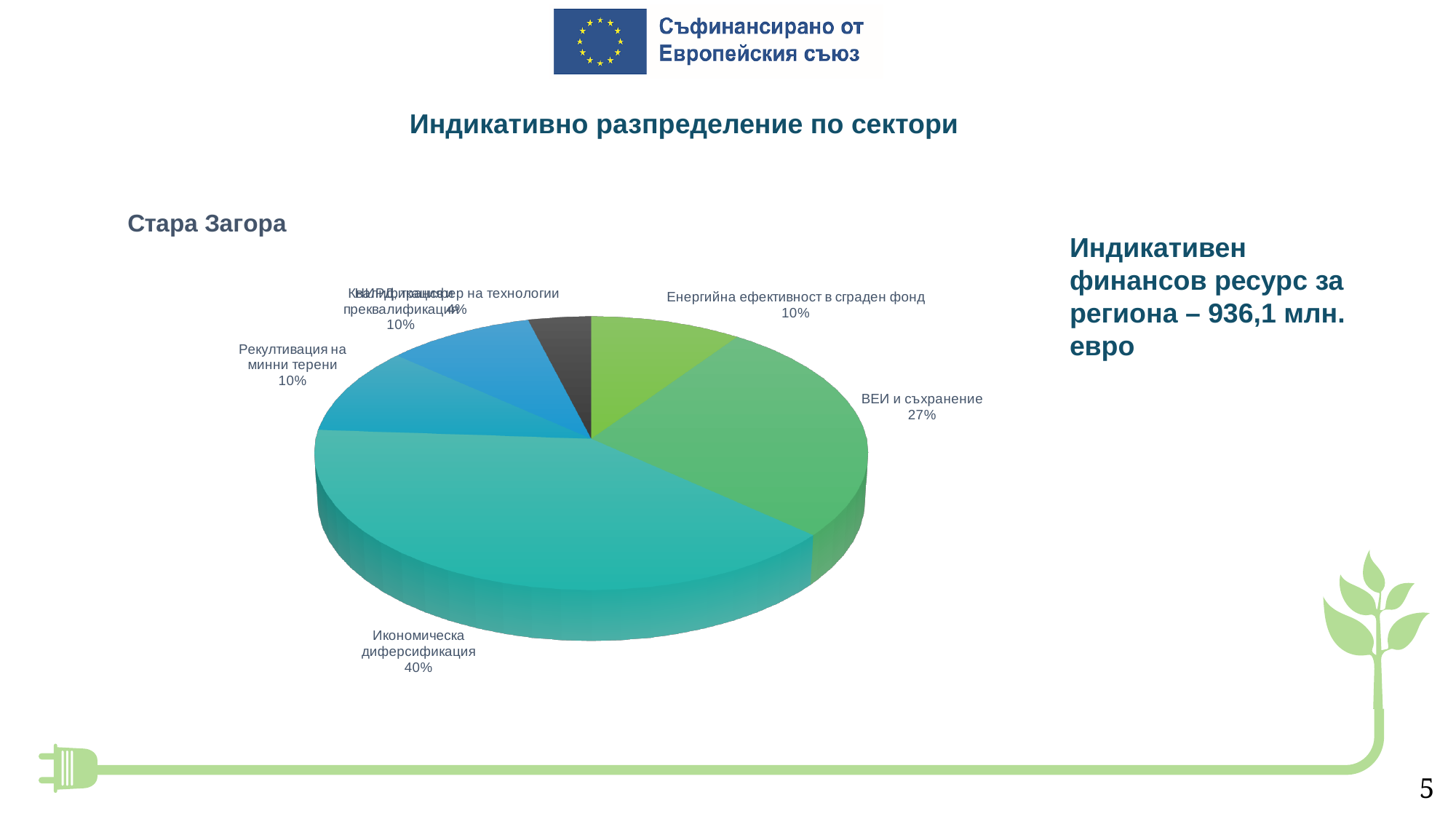
Which is larger, the share for ВЕИ и съхранение or the share for Рекултивация на минни терени? ВЕИ и съхранение Which sector has the smallest slice of the pie? НИРД, трансфер на технологии What is the title of the slide above the chart? Индикативно разпределение по сектори How many slices does the pie chart have? 6 What share of the pie does ВЕИ и съхранение have? 27% Which region is the pie chart labelled with? Стара Загора What share of the pie does Икономическа диверсификация have? 40% What is the difference between the shares of Икономическа диверсификация and ВЕИ и съхранение? 13% What is the value for Енергийна ефективност в сграден фонд? 10% What kind of chart is shown on the slide? pie chart Which sector has the largest slice of the pie? Икономическа диверсификация What is the value for Рекултивация на минни терени? 10%